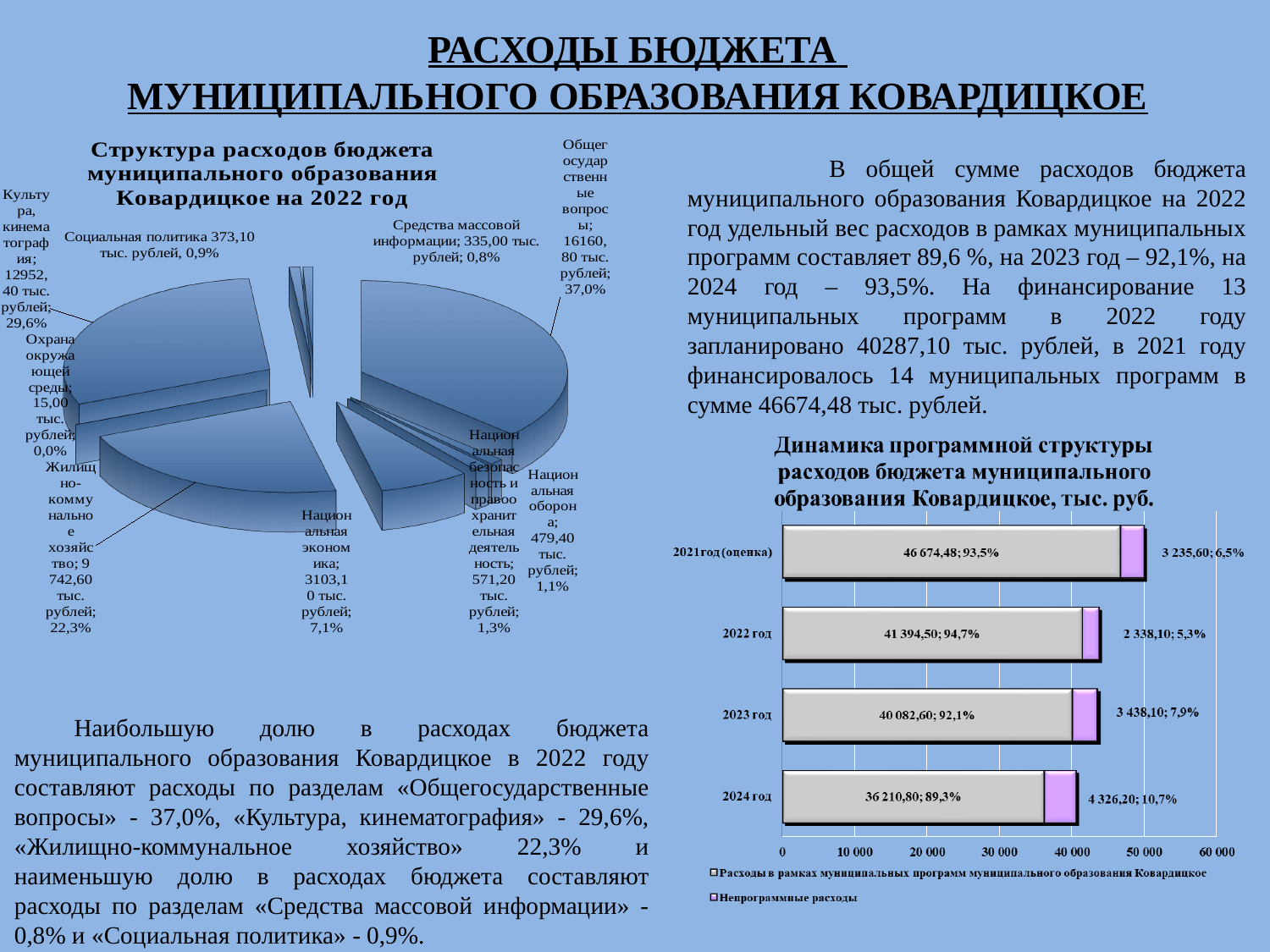
In the pie chart on the left, which category has the largest share? Общегосударственные вопросы In the pie chart on the left, which category has the smallest value? Охрана окружающей среды In the pie chart on the left, how many categories are shown? 9 What type of chart is the chart on the right of the slide? Bar chart In the pie chart 'Структура расходов бюджета муниципального образования Ковардицкое на 2022 год', what share of expenditure goes to 'Общегосударственные вопросы'? 37,0% In the bar chart 'Динамика программной структуры расходов бюджета', what is the value of program expenditure for 2024 год? 36 210,80 In the bar chart on the right, what is the difference between program expenditure in 2021 год (оценка) and 2024 год? 10 463,68 In the pie chart on the left, which is larger: 'Культура, кинематография' or 'Национальная экономика'? Культура, кинематография In the bar chart on the right, what is the total of the stacked bar for 2021 год (оценка)? 49 910,08 In the pie chart on the left, what is the value for 'Жилищно-коммунальное хозяйство'? 9 742,60 тыс. рублей In the bar chart on the right, how many series does the legend list? 2 In the bar chart on the right, what is the value of 'Непрограммные расходы' for 2023 год? 3 438,10